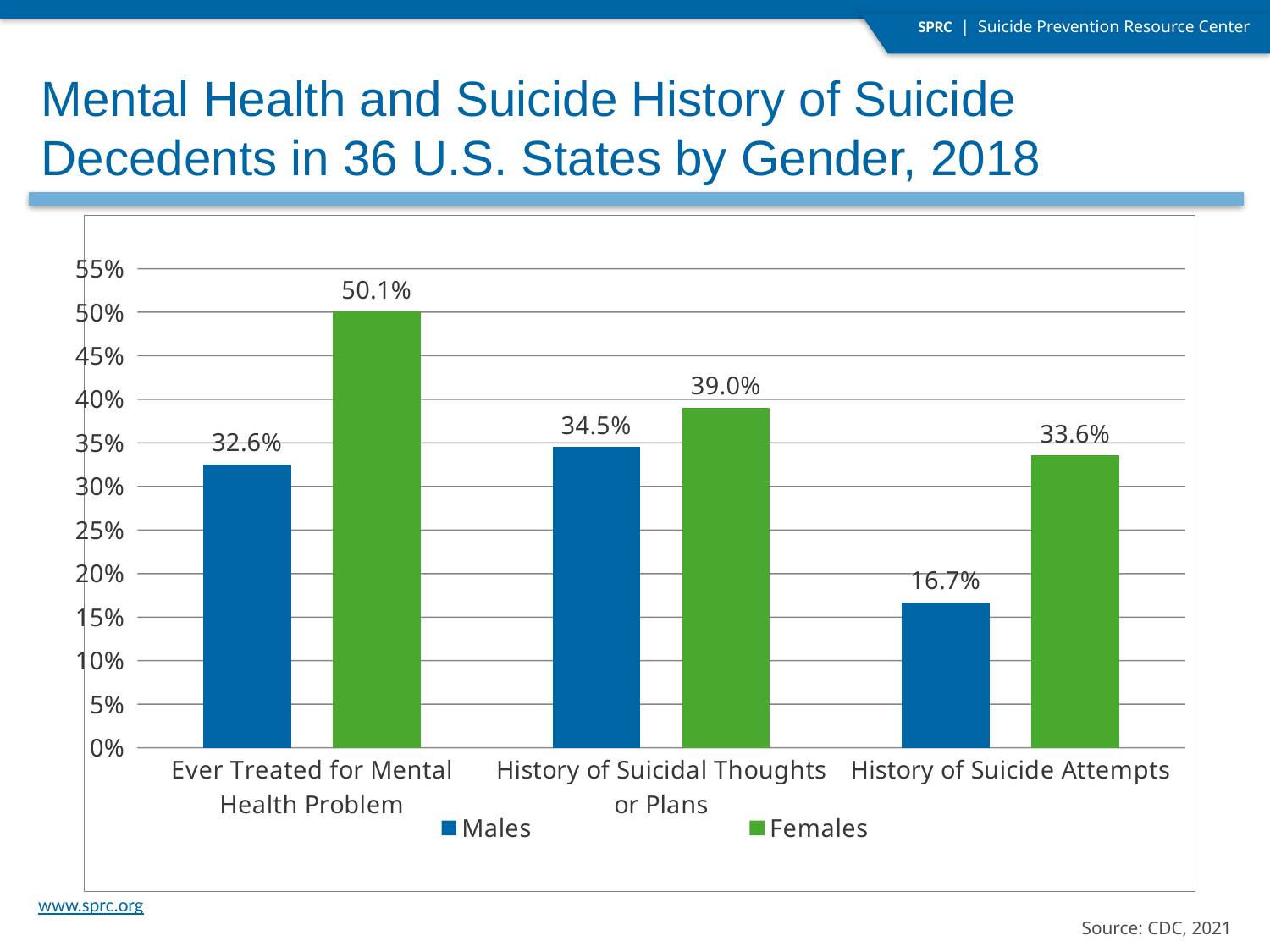
What kind of chart is shown on the slide? Bar chart Which colour represents Females in the chart? Green Which bar in the chart has the highest value? Females, Ever Treated for Mental Health Problem (50.1%) What is the difference between Females and Males for History of Suicide Attempts? 16.9 percentage points Which bar in the chart has the lowest value? Males, History of Suicide Attempts (16.7%) How many series does the legend list? 2 How many categories are shown on the x axis? 3 What percentage of female suicide decedents had a history of suicidal thoughts or plans? 39.0% What is the difference between Females and Males for Ever Treated for Mental Health Problem? 17.5 percentage points What is the value for Males in the History of Suicide Attempts category? 16.7% Which is larger: Males for History of Suicidal Thoughts or Plans or Females for History of Suicide Attempts? Males for History of Suicidal Thoughts or Plans What percentage of male suicide decedents had ever been treated for a mental health problem? 32.6%